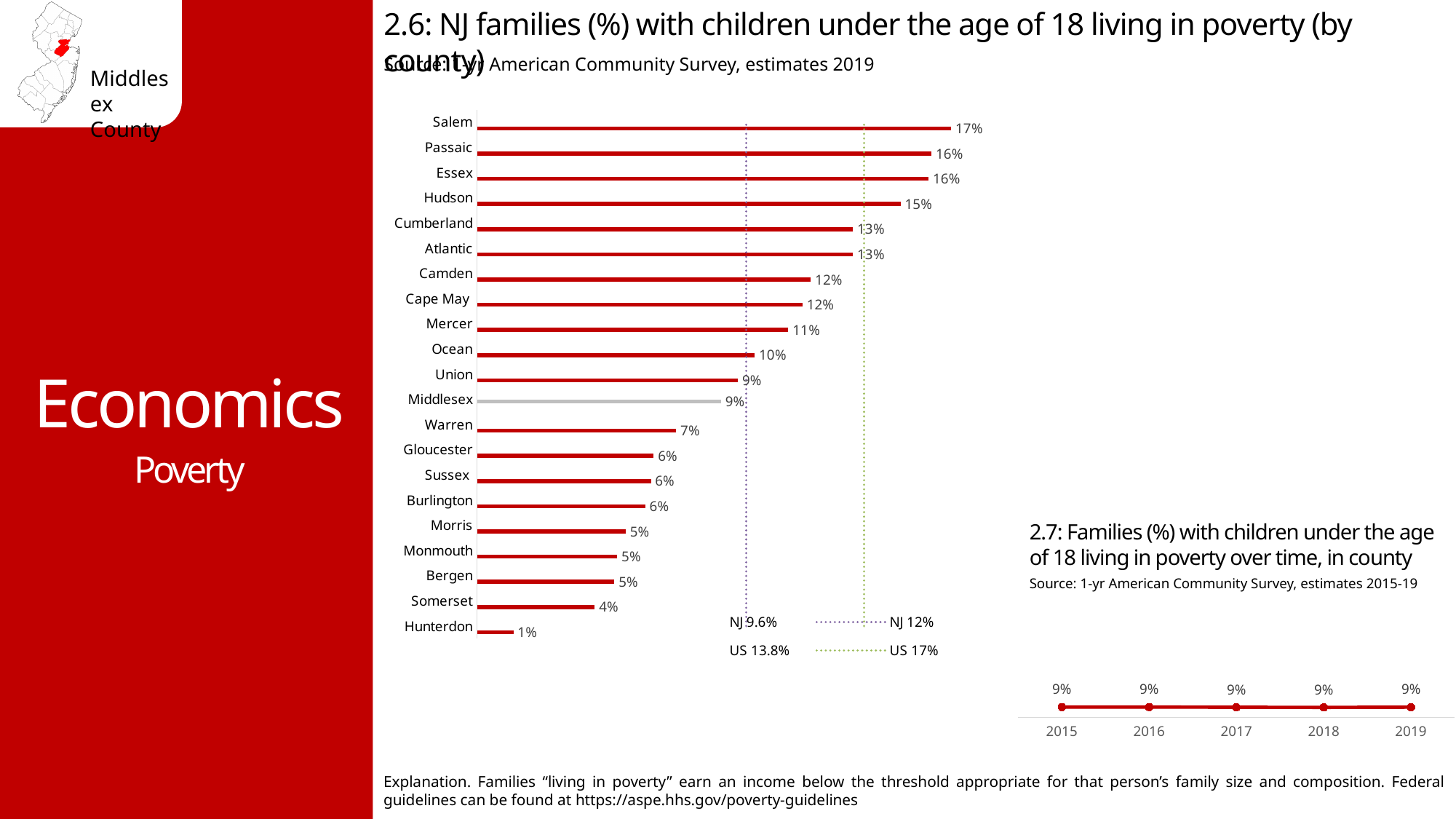
In chart 2.7, how many years are plotted? 5 In chart 2.6, what is the value for Hudson? 15% In chart 2.6, what is the value for Middlesex? 9% In chart 2.6, what is the difference between the values for Salem and Hunterdon? 16% In chart 2.7, what is the value for 2019? 9% In chart 2.6, which county has the highest value? Salem In chart 2.6, what is the difference between the values for Mercer and Somerset? 7% In chart 2.6, which county has the lowest value? Hunterdon In chart 2.6, which is larger, the value for Camden or the value for Warren? Camden What kind of chart is chart 2.6? Bar chart In chart 2.6, how many counties are shown? 21 In chart 2.7, do the values rise, fall or stay flat from 2015 to 2019? Stay flat